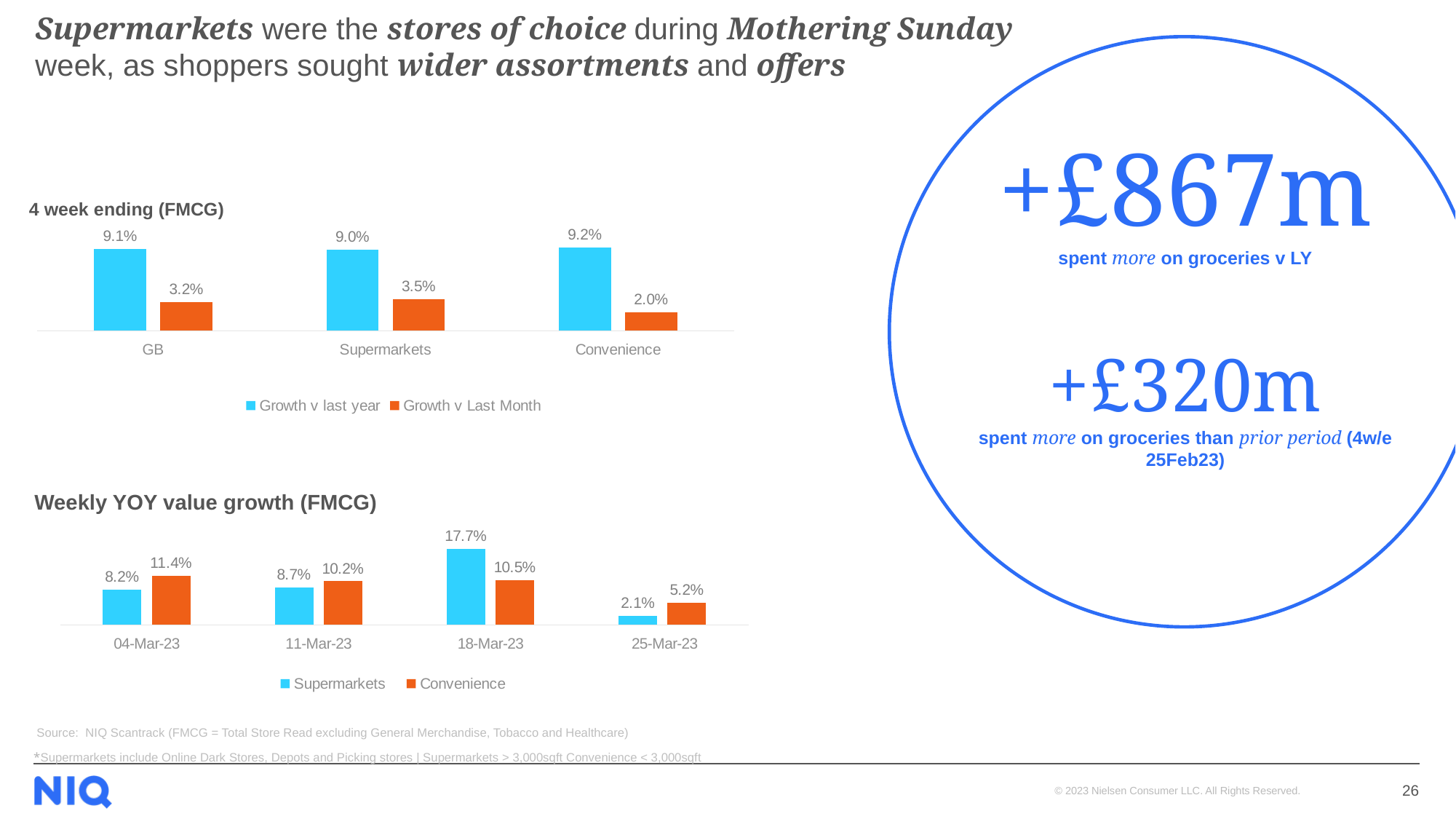
In the 'Weekly YOY value growth (FMCG)' chart, what is the Supermarkets value for 18-Mar-23? 17.7% How many weeks are shown on the x axis of the 'Weekly YOY value growth (FMCG)' chart? 4 In the '4 week ending (FMCG)' chart, what is the Growth v Last Month value for Convenience? 2.0% In the '4 week ending (FMCG)' chart, what is the Growth v last year value for Supermarkets? 9.0% In the 'Weekly YOY value growth (FMCG)' chart, what is the Convenience value for 04-Mar-23? 11.4% In the '4 week ending (FMCG)' chart, how many series does the legend list? 2 In the 'Weekly YOY value growth (FMCG)' chart, which week has the lowest Supermarkets value? 25-Mar-23 In the '4 week ending (FMCG)' chart, what is the difference between Growth v last year and Growth v Last Month for GB? 5.9% What kind of chart is the 'Weekly YOY value growth (FMCG)' chart? Bar chart In the 'Weekly YOY value growth (FMCG)' chart, which is larger for 11-Mar-23: Supermarkets or Convenience? Convenience In the 'Weekly YOY value growth (FMCG)' chart, what is the difference between the Convenience and Supermarkets values for 25-Mar-23? 3.1% In the '4 week ending (FMCG)' chart, which category has the highest Growth v Last Month value? Supermarkets